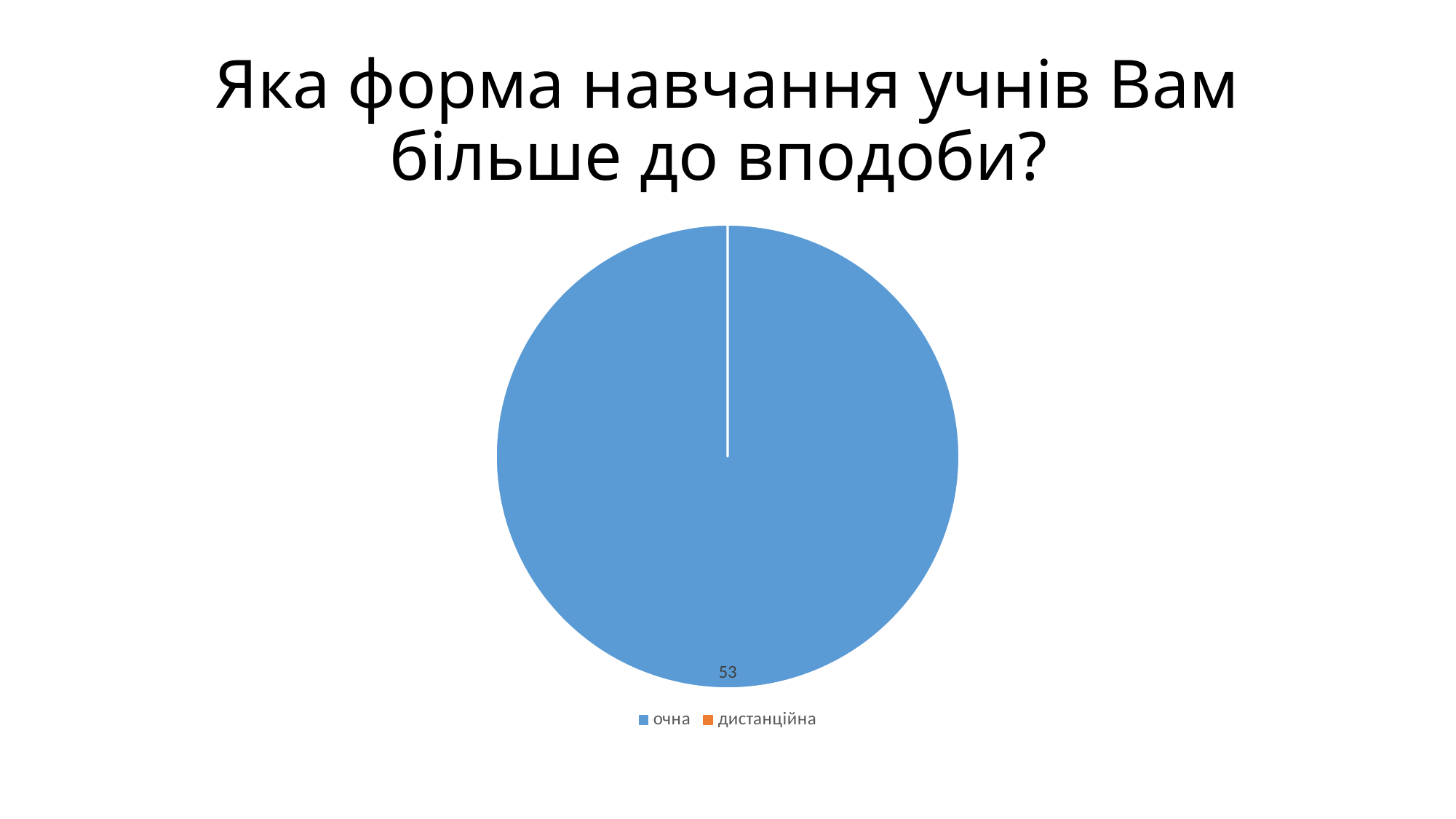
What kind of chart is shown on the slide? pie chart Which category has the smallest slice of the pie? дистанційна What is the title of the slide? Яка форма навчання учнів Вам більше до вподоби? What is the value shown for the очна slice? 53 Is the value for очна greater or less than 50? greater How many entries does the legend list? 2 What colour is the очна slice? blue Which is larger, the slice for очна or the slice for дистанційна? очна Which category has the largest slice of the pie? очна